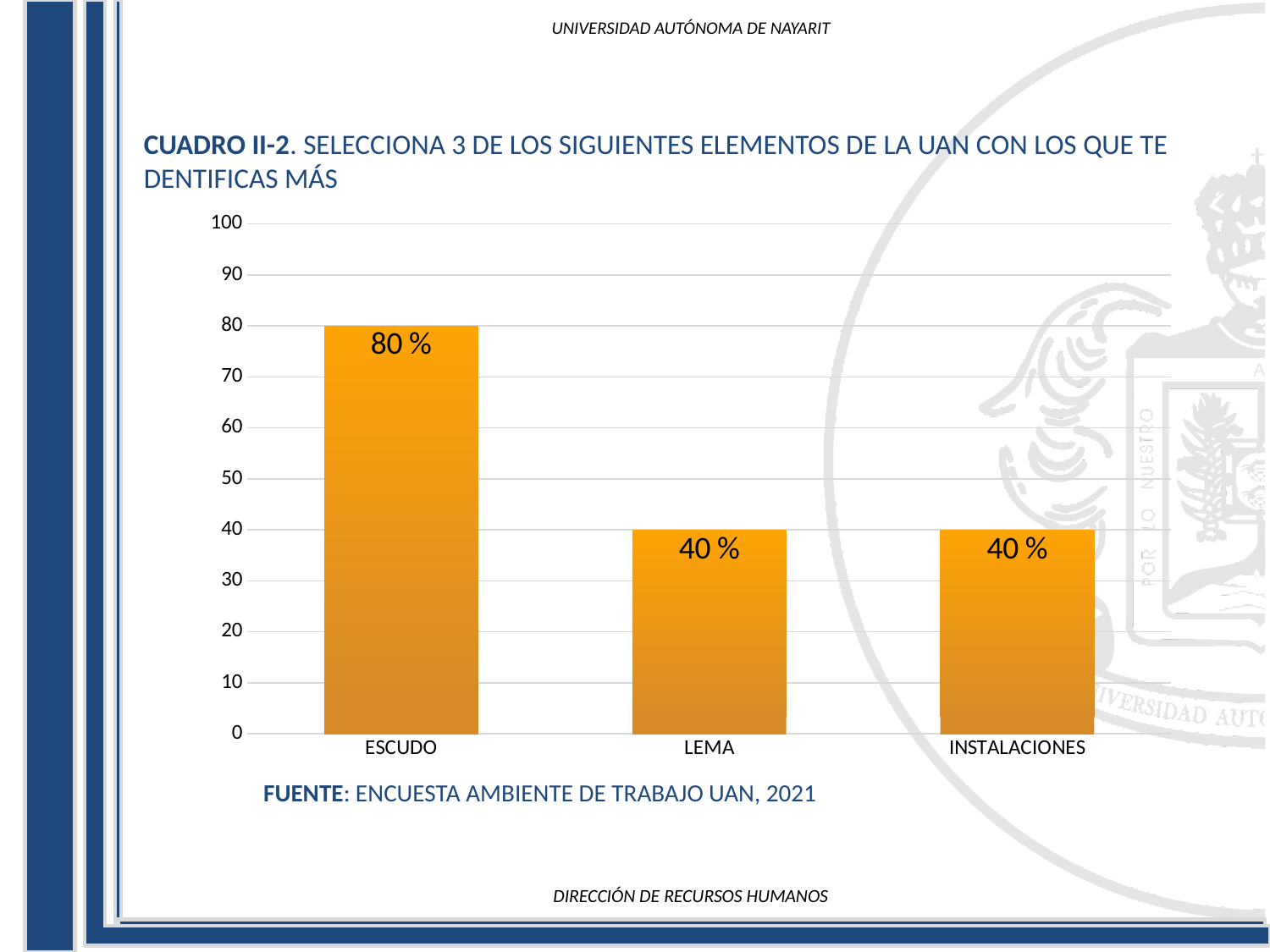
What is the value for ESCUDO? 80 % What is the maximum value shown on the y axis? 100 What is the value for LEMA? 40 % What kind of chart is shown on the slide? bar chart Is the value for ESCUDO greater or less than 70? greater Which category has the highest value? ESCUDO Which is larger, the value for ESCUDO or the value for INSTALACIONES? ESCUDO What is the source cited below the chart? ENCUESTA AMBIENTE DE TRABAJO UAN, 2021 What is the difference between the values for ESCUDO and LEMA? 40 % Is the value for LEMA greater or less than 50? less What is the value for INSTALACIONES? 40 % How many categories are shown on the x axis? 3